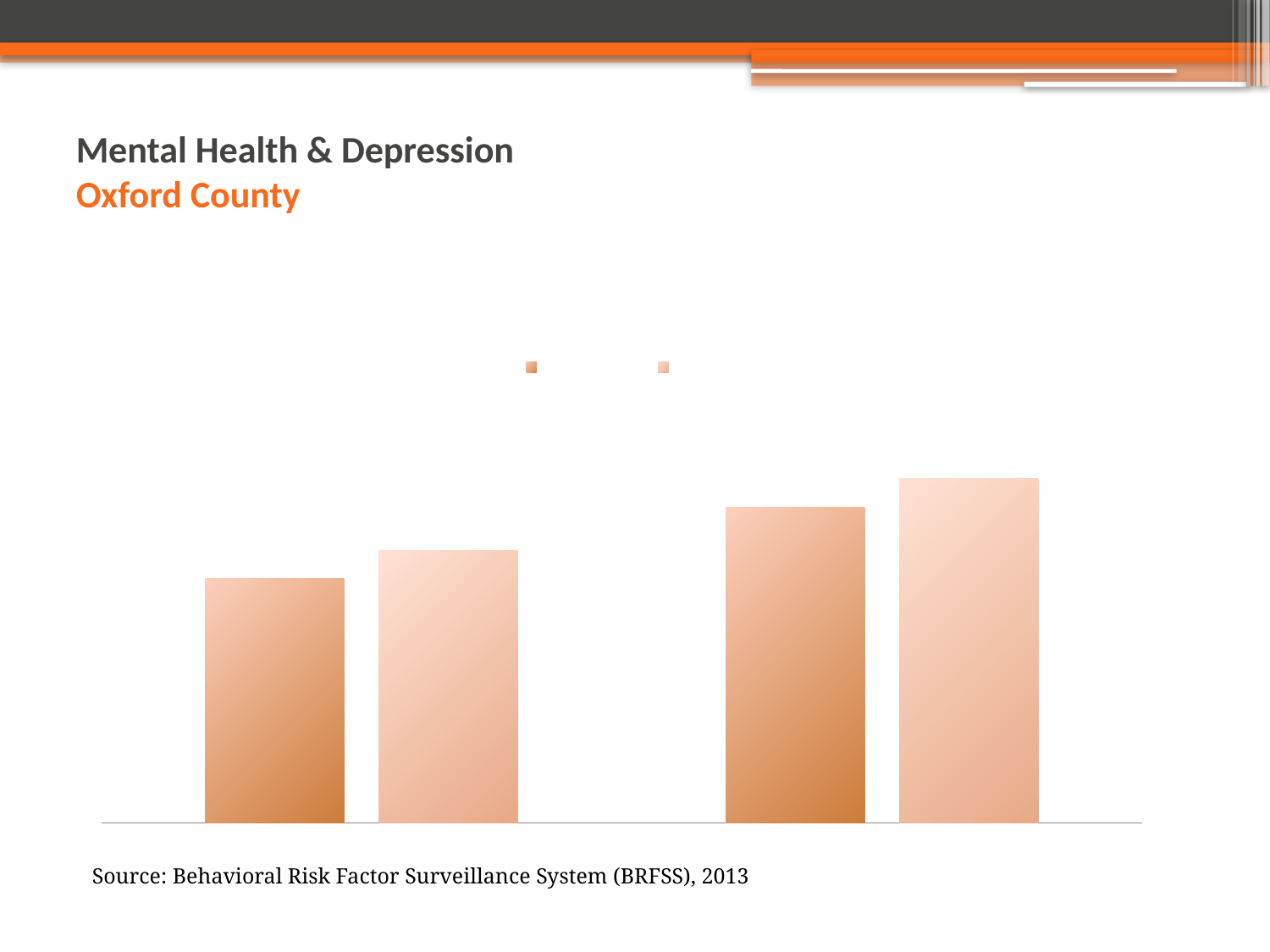
Which bar is the shortest in the chart? the leftmost bar What kind of chart is shown on the slide? bar chart In the right group of bars, which bar is taller, the darker orange bar or the lighter bar? the lighter bar Which bar is the tallest in the chart? the rightmost bar How many groups of bars are there in the chart? 2 In the left group of bars, which bar is taller, the darker orange bar or the lighter bar? the lighter bar Which group of bars is taller overall, the left group or the right group? the right group What is the title of the slide containing the chart? Mental Health & Depression How many series does the chart's legend list? 2 How many bars are plotted in the chart? 4 Do the bar heights rise or fall from left to right across the chart? rise What source is cited below the chart? Behavioral Risk Factor Surveillance System (BRFSS), 2013